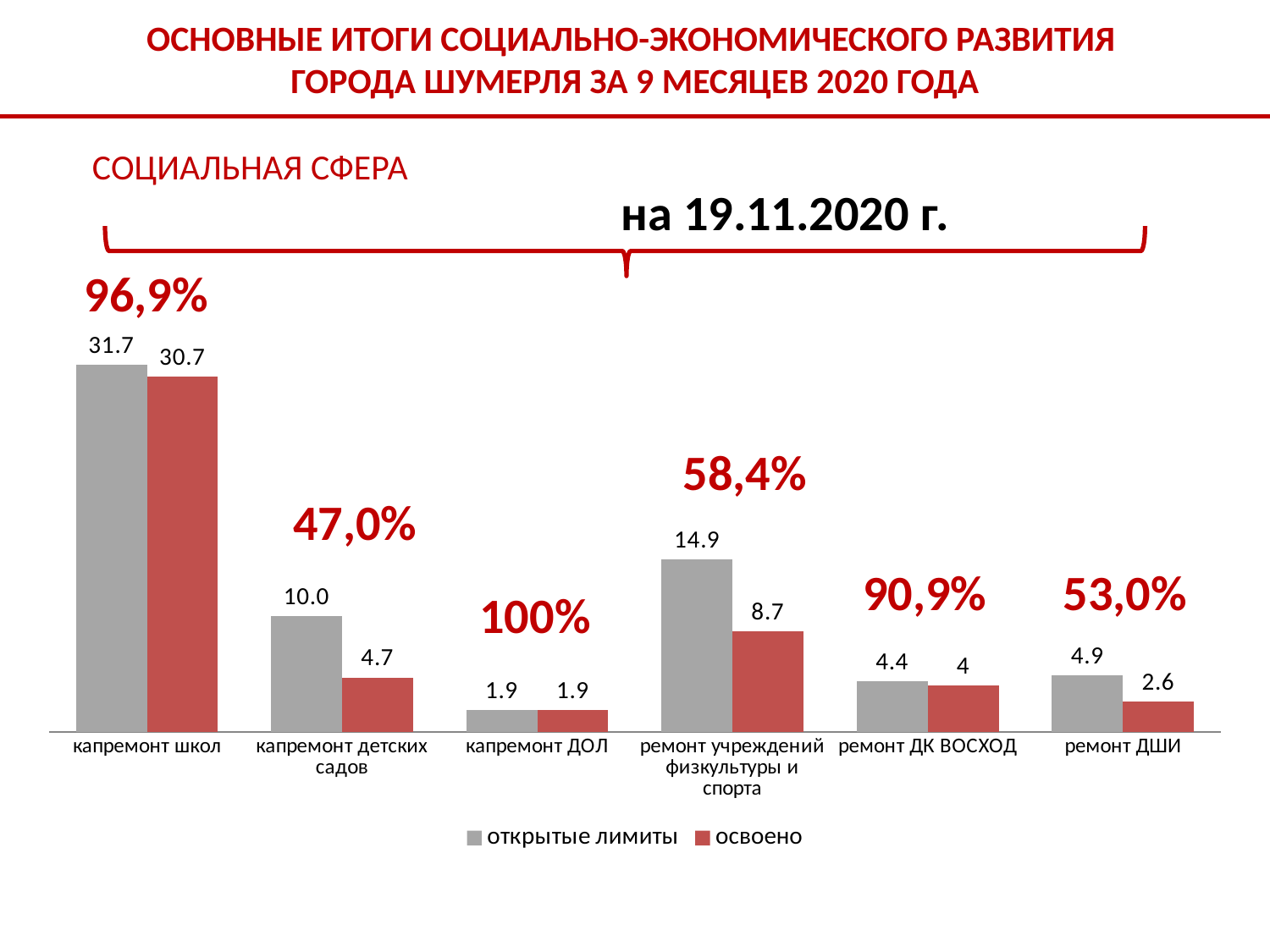
What is the value of 'открытые лимиты' for 'капремонт школ'? 31.7 What is the difference between 'открытые лимиты' and 'освоено' for 'капремонт детских садов'? 5.3 Which category has the lowest value for 'освоено'? капремонт ДОЛ What is the value of 'освоено' for 'ремонт учреждений физкультуры и спорта'? 8.7 What is the difference between 'открытые лимиты' and 'освоено' for 'ремонт учреждений физкультуры и спорта'? 6.2 Which category has the highest value for 'открытые лимиты'? капремонт школ What kind of chart is shown on the slide? bar chart Which is larger: 'освоено' for 'ремонт ДК ВОСХОД' or 'освоено' for 'ремонт ДШИ'? ремонт ДК ВОСХОД How many categories are shown on the x axis? 6 How many series does the legend list? 2 What percentage label is shown above the 'капремонт ДОЛ' bars? 100% What is the value of 'освоено' for 'капремонт детских садов'? 4.7